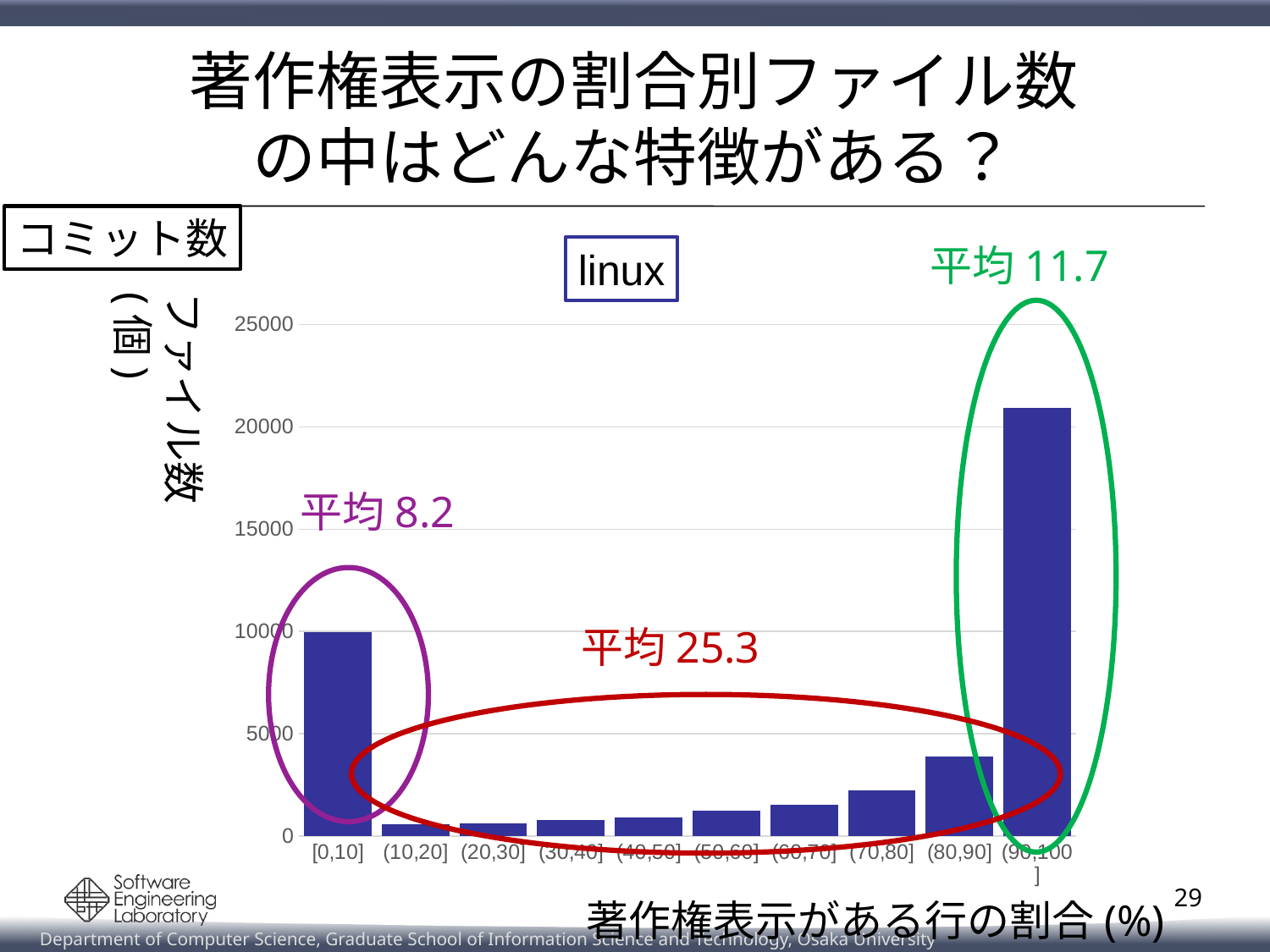
What kind of chart is shown on the slide? bar chart Which project name is shown in the box above the chart? linux Is the value for (80,90] greater or less than 5000? less Do the values rise or fall from (10,20] to (80,90] along the x axis? rise Which is larger, the value for (90,100] or the value for [0,10]? (90,100] Is the value for (90,100] greater or less than 20000? greater How many categories are shown on the x axis of the chart? 10 Which is larger, the value for [0,10] or the value for (80,90]? [0,10] Is the value for (70,80] greater or less than 5000? less What average (平均) value is annotated in green next to the (90,100] bar? 11.7 Which category has the highest number of files? (90,100]